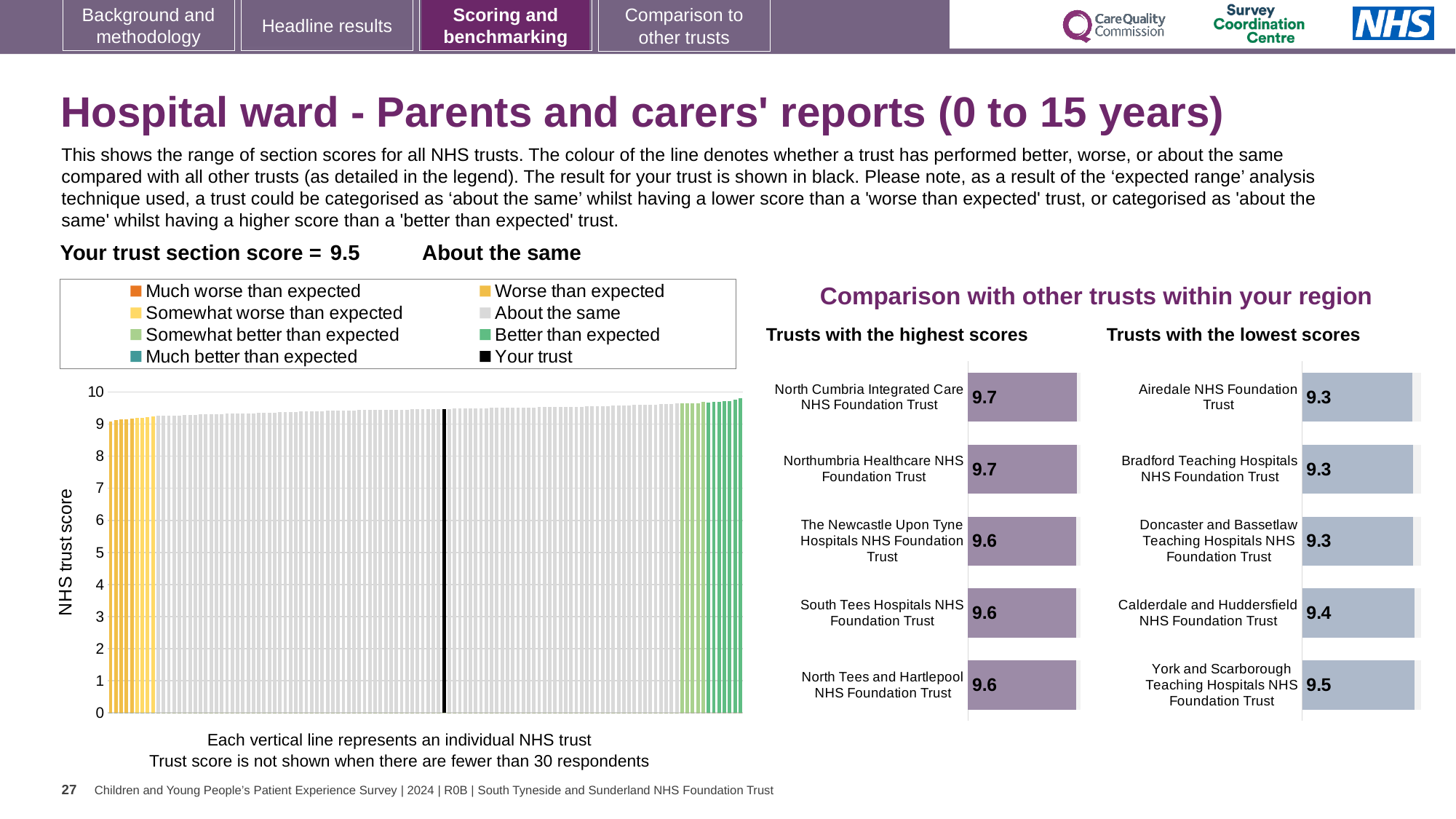
How many entries does the legend of the 'NHS trust score' chart list? 8 How many trusts are shown in the 'Trusts with the lowest scores' chart? 5 In the 'NHS trust score' chart on the left, do the trust scores rise or fall from left to right along the x axis? Rise In the 'Trusts with the lowest scores' chart, what is the score for Calderdale and Huddersfield NHS Foundation Trust? 9.4 What kind of chart is the 'NHS trust score' chart on the left of the slide? Bar chart In the 'Trusts with the highest scores' chart, what is the score for North Cumbria Integrated Care NHS Foundation Trust? 9.7 In the 'Trusts with the highest scores' chart, what is the score for South Tees Hospitals NHS Foundation Trust? 9.6 What is the difference between the score for North Cumbria Integrated Care NHS Foundation Trust in the highest scores chart and Airedale NHS Foundation Trust in the lowest scores chart? 0.4 In the 'Trusts with the lowest scores' chart, which trust has the highest score? York and Scarborough Teaching Hospitals NHS Foundation Trust In the 'NHS trust score' chart on the left, is the value for 'Your trust' (the black line) greater or less than 9? greater How many trusts are shown in the 'Trusts with the highest scores' chart? 5 In the 'Trusts with the lowest scores' chart, which is larger: the score for Calderdale and Huddersfield NHS Foundation Trust or York and Scarborough Teaching Hospitals NHS Foundation Trust? York and Scarborough Teaching Hospitals NHS Foundation Trust